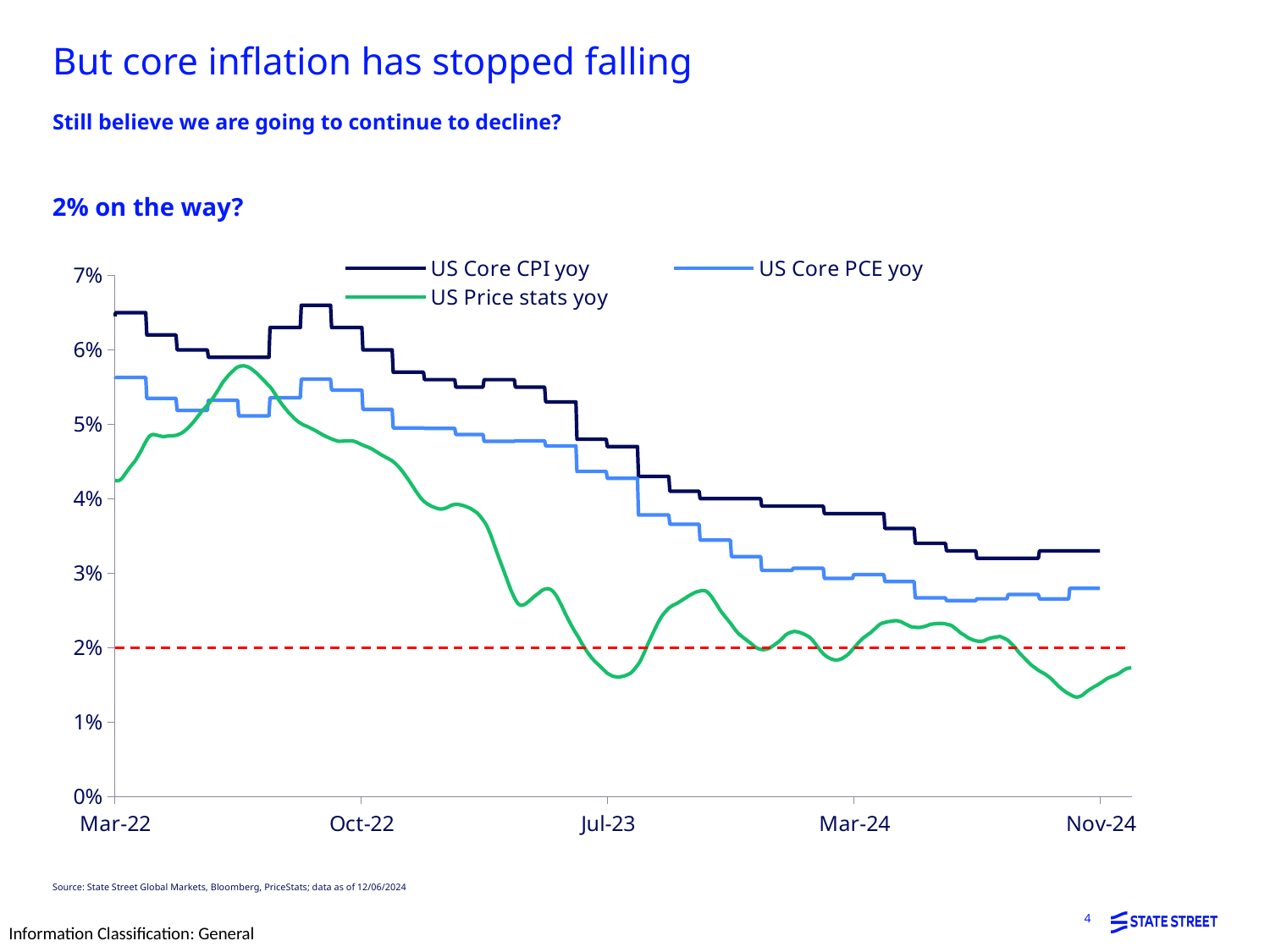
At Mar-22, which is higher: US Core CPI yoy or US Core PCE yoy? US Core CPI yoy Is the value for US Price stats yoy at Nov-24 greater or less than 2%? less At what level is the red dashed horizontal line drawn? 2% Does US Core CPI yoy rise or fall overall from Mar-22 to Nov-24? fall How many series does the chart legend list? 3 Which series has the lowest value at Nov-24? US Price stats yoy Is the value for US Core CPI yoy at Nov-24 greater or less than 3%? greater What colour is the US Price stats yoy line? green Is the value for US Core CPI yoy at Mar-22 greater or less than 6%? greater What is the title of the chart? 2% on the way? What kind of chart is shown on the slide? line chart